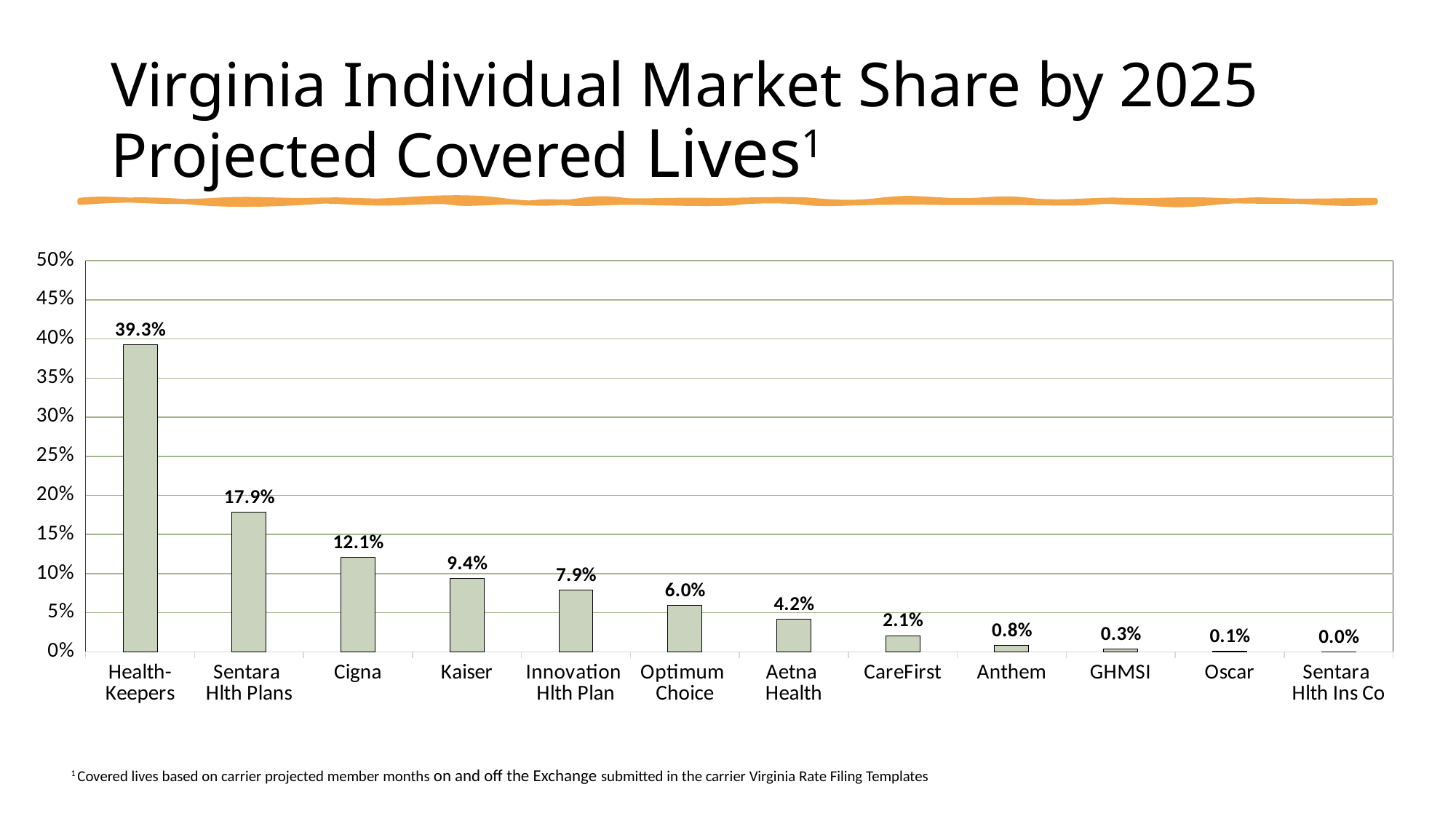
Which has a larger market share, Optimum Choice or Aetna Health? Optimum Choice Which carrier has the lowest projected market share? Sentara Hlth Ins Co How many carriers are shown on the chart? 12 What is the projected market share for Kaiser? 9.4% Is the value for Innovation Hlth Plan greater or less than 10%? less What is the difference in market share between Sentara Hlth Plans and Cigna? 5.8% What is the projected market share for HealthKeepers? 39.3% What is the maximum value shown on the y axis? 50% Do the values rise or fall moving from left to right along the x axis? fall What kind of chart is shown on the slide? bar chart Which carrier has the highest projected market share? HealthKeepers What is the projected market share for CareFirst? 2.1%